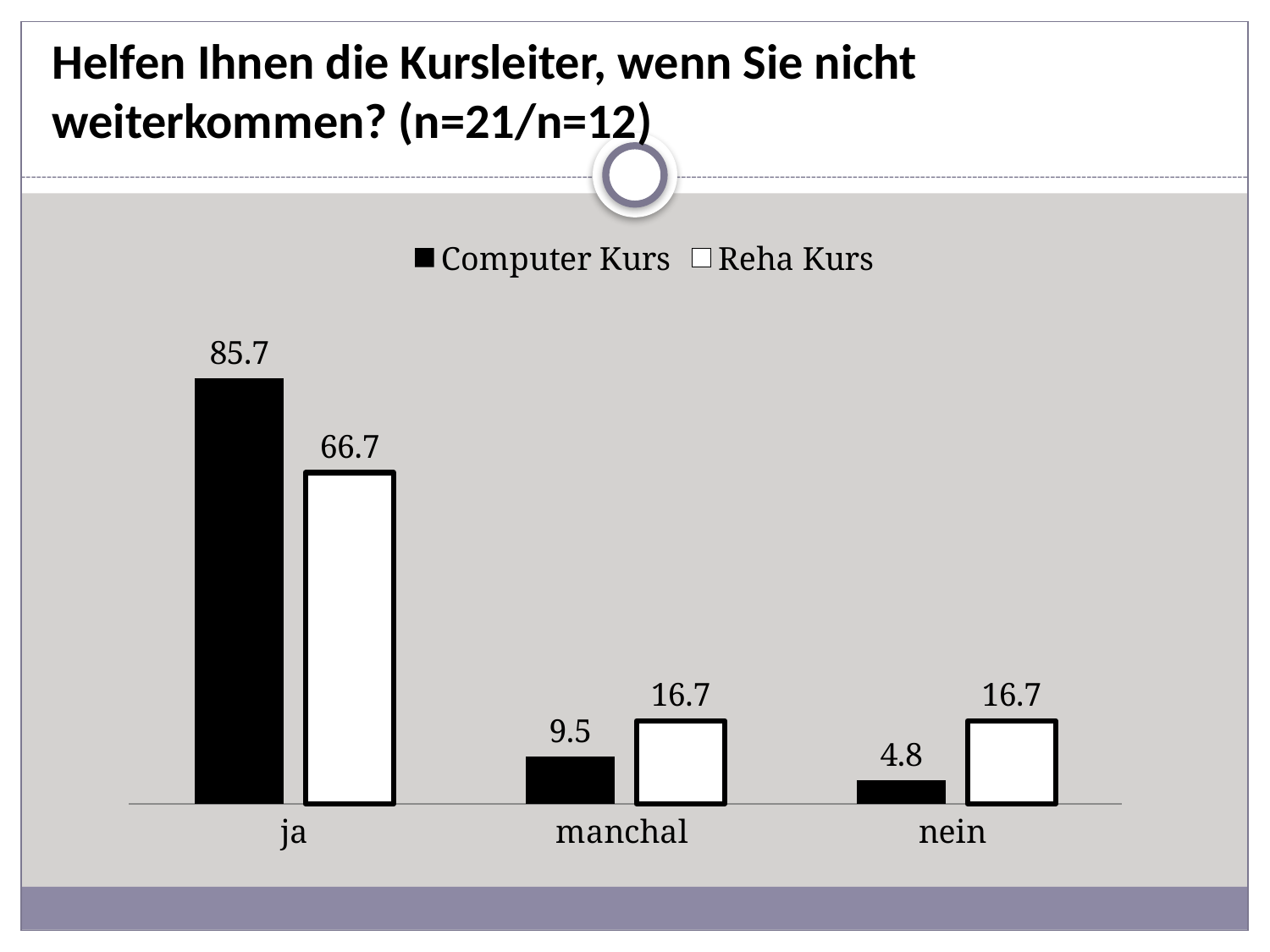
What is the value for Reha Kurs in the 'nein' category? 16.7 What kind of chart is shown on the slide? bar chart Which category has the lowest value for Computer Kurs? nein What is the value for Reha Kurs in the 'ja' category? 66.7 How many series does the legend list? 2 What is the value for Computer Kurs in the 'ja' category? 85.7 What is the difference between the Computer Kurs and Reha Kurs values in the 'ja' category? 19 What is the value for Computer Kurs in the 'nein' category? 4.8 What is the value for Computer Kurs in the 'manchal' category? 9.5 Which category has the highest value for Computer Kurs? ja In the 'manchal' category, which series has the larger value, Computer Kurs or Reha Kurs? Reha Kurs How many categories are shown on the x axis? 3